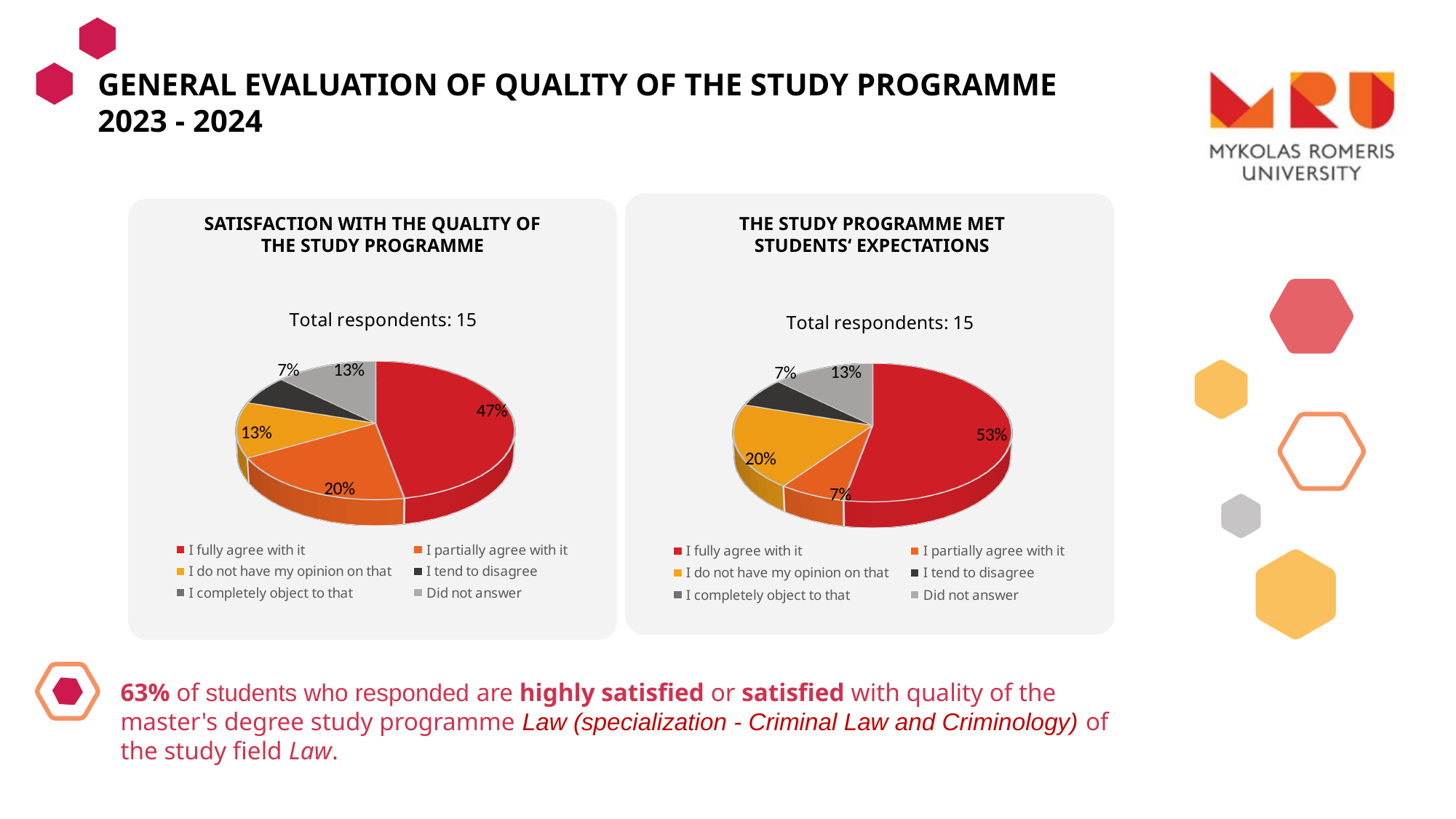
In the 'The study programme met students' expectations' pie chart, what share of respondents partially agree with it? 7% How many total respondents are reported for the 'The study programme met students' expectations' chart? 15 In the 'The study programme met students' expectations' pie chart, what share of respondents fully agree with it? 53% In the 'Satisfaction with the quality of the study programme' pie chart, what share of respondents partially agree with it? 20% In the 'The study programme met students' expectations' pie chart, what is the difference between the 'I fully agree with it' share and the 'I do not have my opinion on that' share? 33 percentage points In the 'The study programme met students' expectations' pie chart, what share of respondents do not have an opinion on that? 20% What type of chart is used on this slide? Pie chart Which chart has a larger 'I fully agree with it' share: 'Satisfaction with the quality of the study programme' or 'The study programme met students' expectations'? The study programme met students' expectations In the 'Satisfaction with the quality of the study programme' pie chart, what share of respondents fully agree with it? 47% In the 'Satisfaction with the quality of the study programme' pie chart, which response has the smallest visible share? I tend to disagree How many entries does the legend of the 'Satisfaction with the quality of the study programme' chart list? 6 In the 'Satisfaction with the quality of the study programme' pie chart, which response has the largest share? I fully agree with it